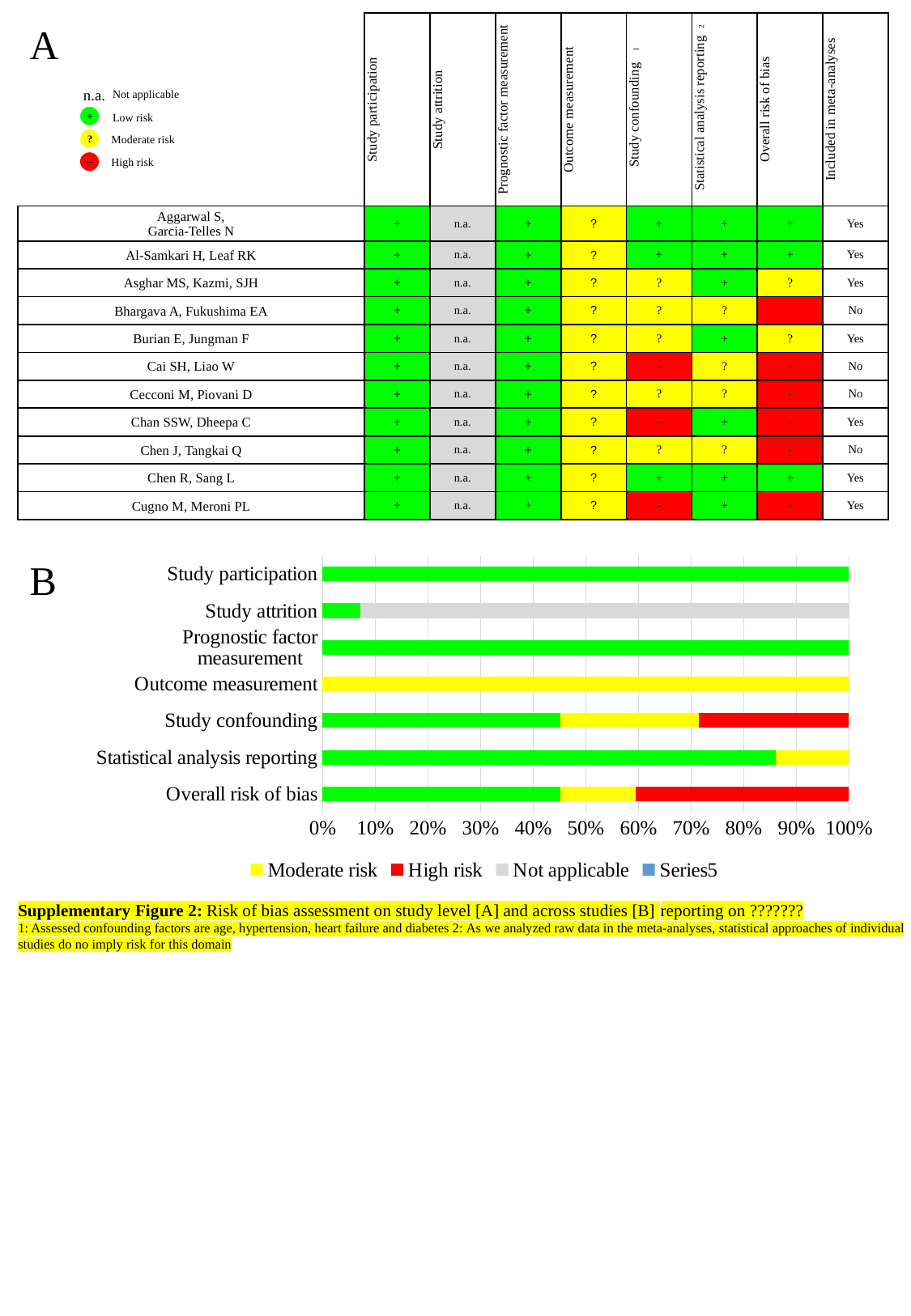
In chart B, does the green segment for Study confounding end at a value greater or less than 60%? less In chart B, which category's bar contains a grey (Not applicable) segment? Study attrition What kind of chart is chart B? bar chart In chart B, is the red segment larger for Overall risk of bias or for Study confounding? Overall risk of bias What is the highest value shown on the x axis of chart B? 100% In chart B, does the green segment for Overall risk of bias end at a value greater or less than 30%? greater In chart B, is the green segment for Study attrition greater or less than 20%? less In chart B, is the green segment larger for Statistical analysis reporting or for Study confounding? Statistical analysis reporting How many categories are shown on the y axis of chart B? 7 How many series does the legend of chart B list? 4 In chart B, which category's bar is entirely yellow (Moderate risk)? Outcome measurement